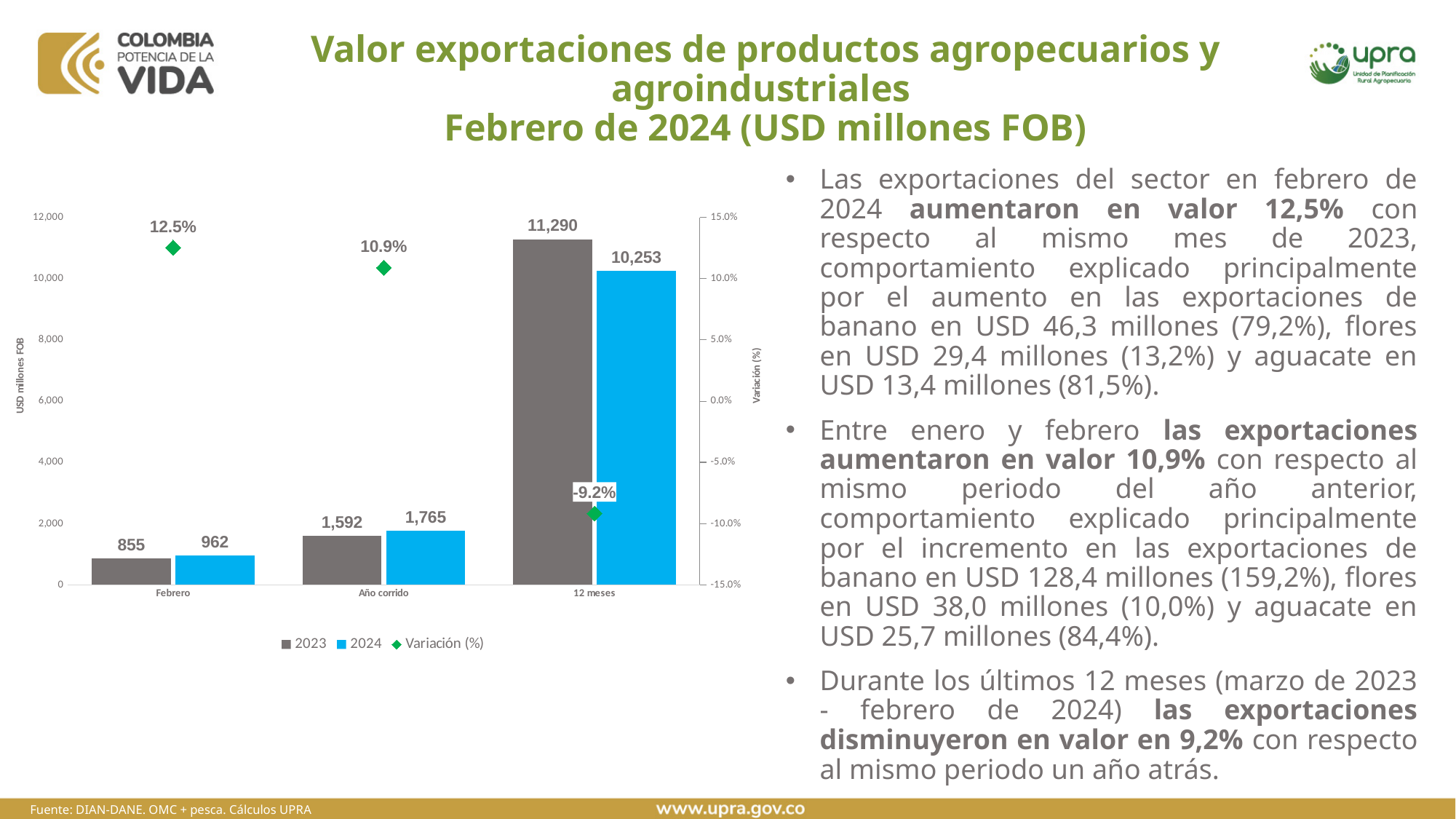
What is the 2023 value for Febrero? 855 Which category has the lowest 2024 value? Febrero What is the Variación (%) value for 12 meses? -9.2% How many categories are shown on the x axis? 3 What is the difference between the 2023 and 2024 values for 12 meses? 1,037 What is the 2024 value for Año corrido? 1,765 What is the Variación (%) value for Febrero? 12.5% What is the 2024 value for 12 meses? 10,253 How many series does the legend list? 3 Which is larger for Año corrido, the 2023 value or the 2024 value? 2024 What kind of chart is shown on the slide? Bar chart with a line/marker series Which category has the highest 2023 value? 12 meses